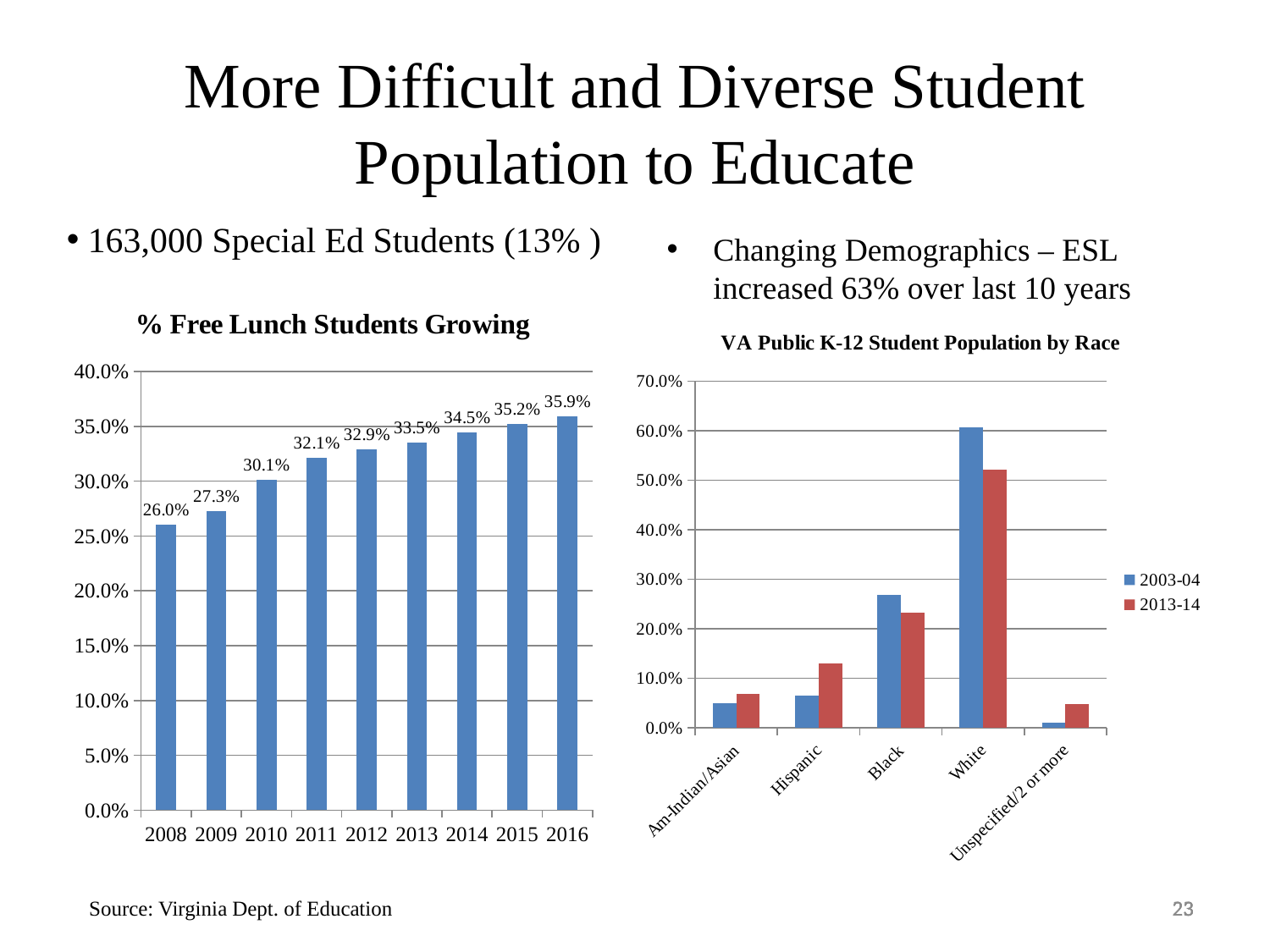
In the '% Free Lunch Students Growing' chart, which year has the highest value? 2016 In the '% Free Lunch Students Growing' chart, how many years are shown on the x axis? 9 In the 'VA Public K-12 Student Population by Race' chart, is the 2013-14 value for Hispanic greater or less than 10.0%? greater In the '% Free Lunch Students Growing' chart, what is the difference between the 2016 value and the 2008 value? 9.9% In the 'VA Public K-12 Student Population by Race' chart, which category has the highest value for 2003-04? White In the '% Free Lunch Students Growing' chart, what is the value for 2008? 26.0% In the '% Free Lunch Students Growing' chart, do the values rise or fall from 2008 to 2016? rise In the 'VA Public K-12 Student Population by Race' chart, which is larger for Black: the 2003-04 value or the 2013-14 value? 2003-04 In the 'VA Public K-12 Student Population by Race' chart, is the 2013-14 value for White greater or less than 50.0%? greater How many series does the legend of the 'VA Public K-12 Student Population by Race' chart list? 2 In the '% Free Lunch Students Growing' chart, what is the value for 2012? 32.9% What kind of chart is the 'VA Public K-12 Student Population by Race' chart? bar chart